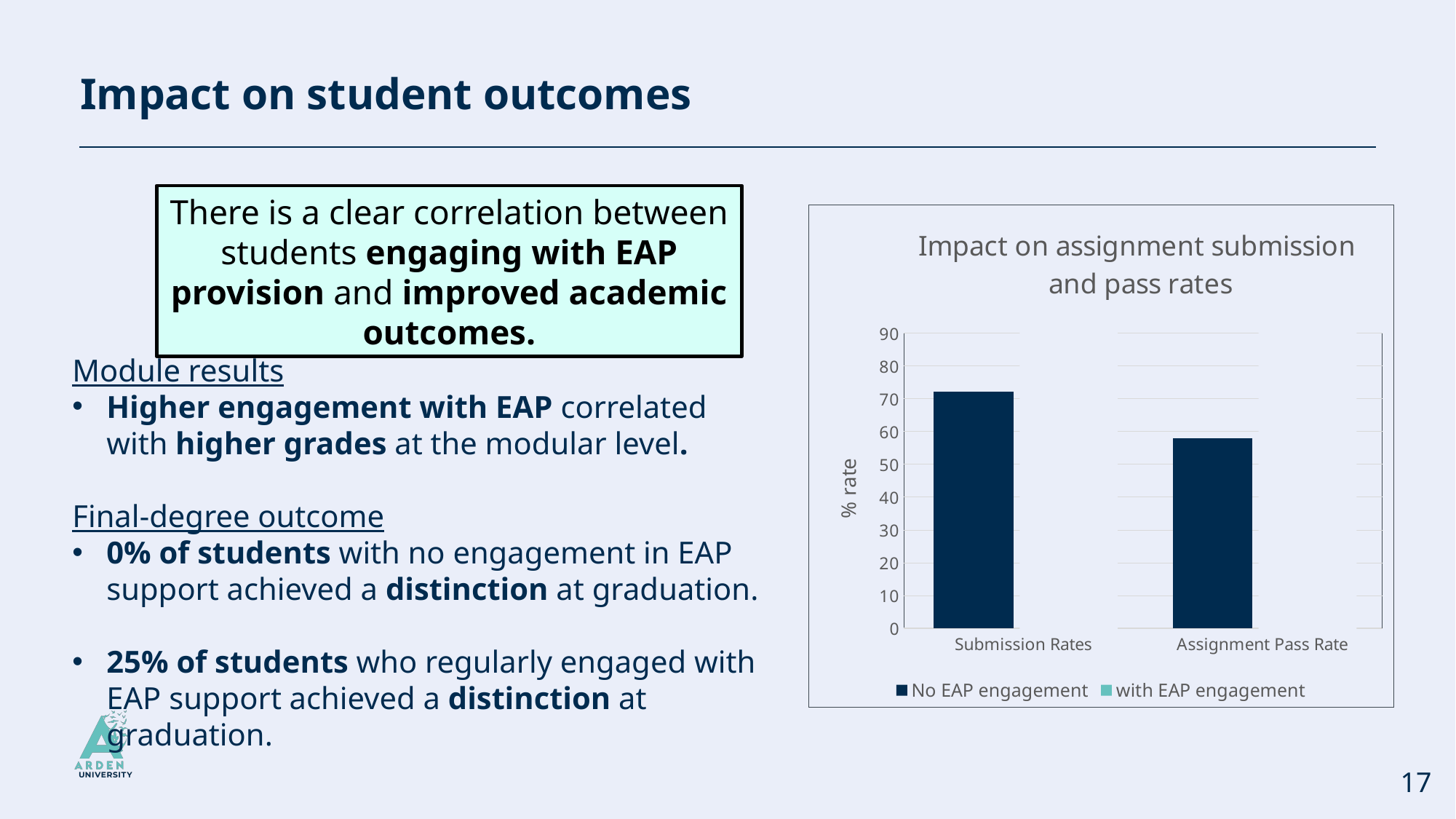
How many series does the chart legend list? 2 How many categories are shown on the x axis of the chart? 2 Is the No EAP engagement value for Assignment Pass Rate greater or less than 50? greater What is the title of the chart? Impact on assignment submission and pass rates What is the label on the vertical axis of the chart? % rate Is the No EAP engagement value for Submission Rates greater or less than 60? greater What kind of chart is shown on the slide? bar chart Is the No EAP engagement value for Assignment Pass Rate greater or less than 70? less Which category has the lowest bar for No EAP engagement? Assignment Pass Rate Which category has the highest bar for No EAP engagement? Submission Rates Which is larger for No EAP engagement: Submission Rates or Assignment Pass Rate? Submission Rates Do the No EAP engagement values rise or fall from Submission Rates to Assignment Pass Rate? fall